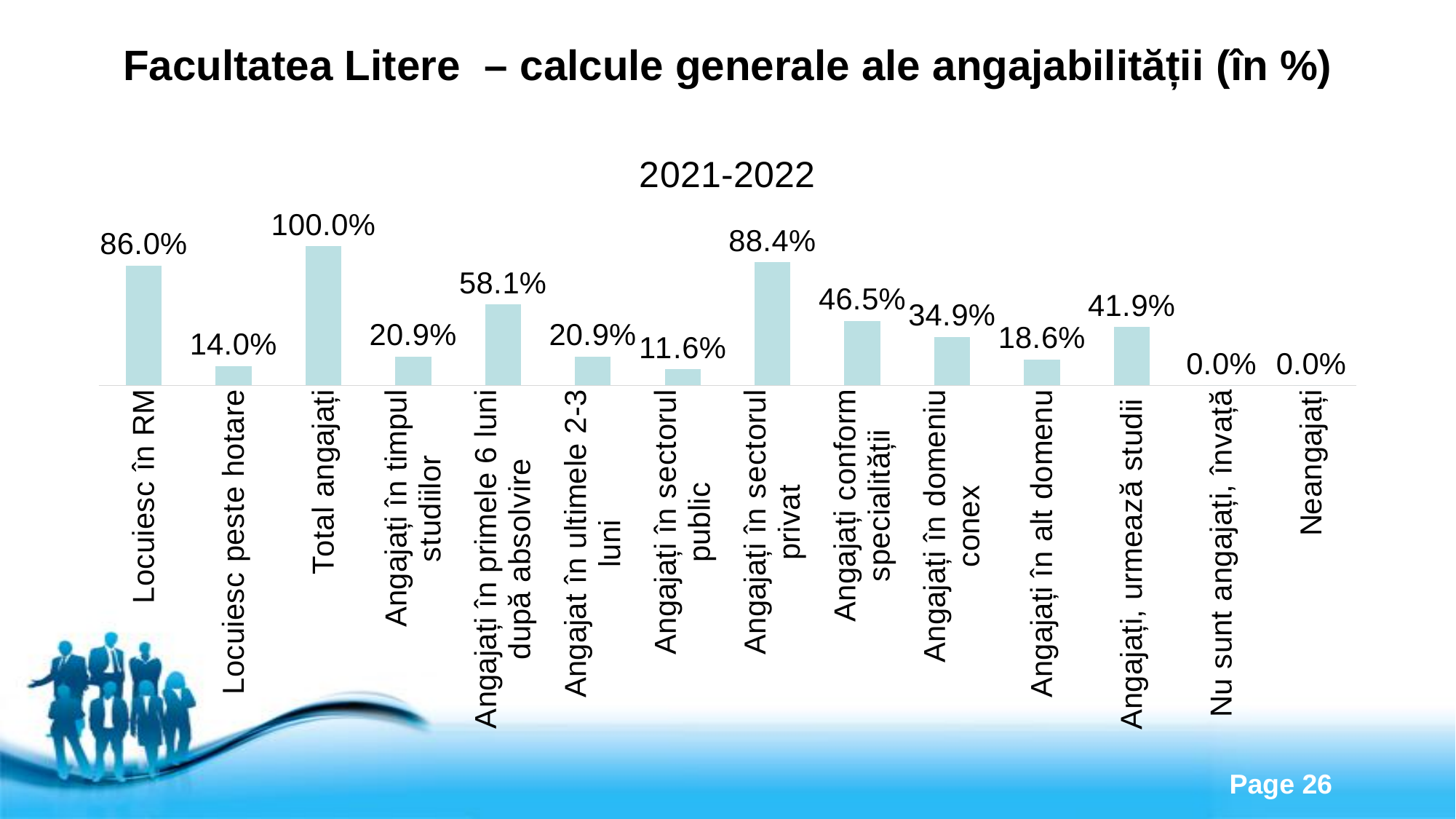
What is the difference between Angajați în sectorul privat and Angajați în sectorul public? 76.8% What is the value for Angajați conform specialității? 46.5% What type of chart is shown on the slide? Bar chart What is the value for Angajați, urmează studii? 41.9% What is the difference between Locuiesc în RM and Locuiesc peste hotare? 72.0% How many categories have a value of 0.0%? 2 Which category has the highest value? Total angajați Which is larger, Angajați în primele 6 luni după absolvire or Angajați în timpul studiilor? Angajați în primele 6 luni după absolvire How many categories are shown in the chart? 14 What is the value for Locuiesc în RM? 86.0% What is the value for Angajați în sectorul privat? 88.4% Which is larger, Angajați în domeniu conex or Angajați în alt domenu? Angajați în domeniu conex